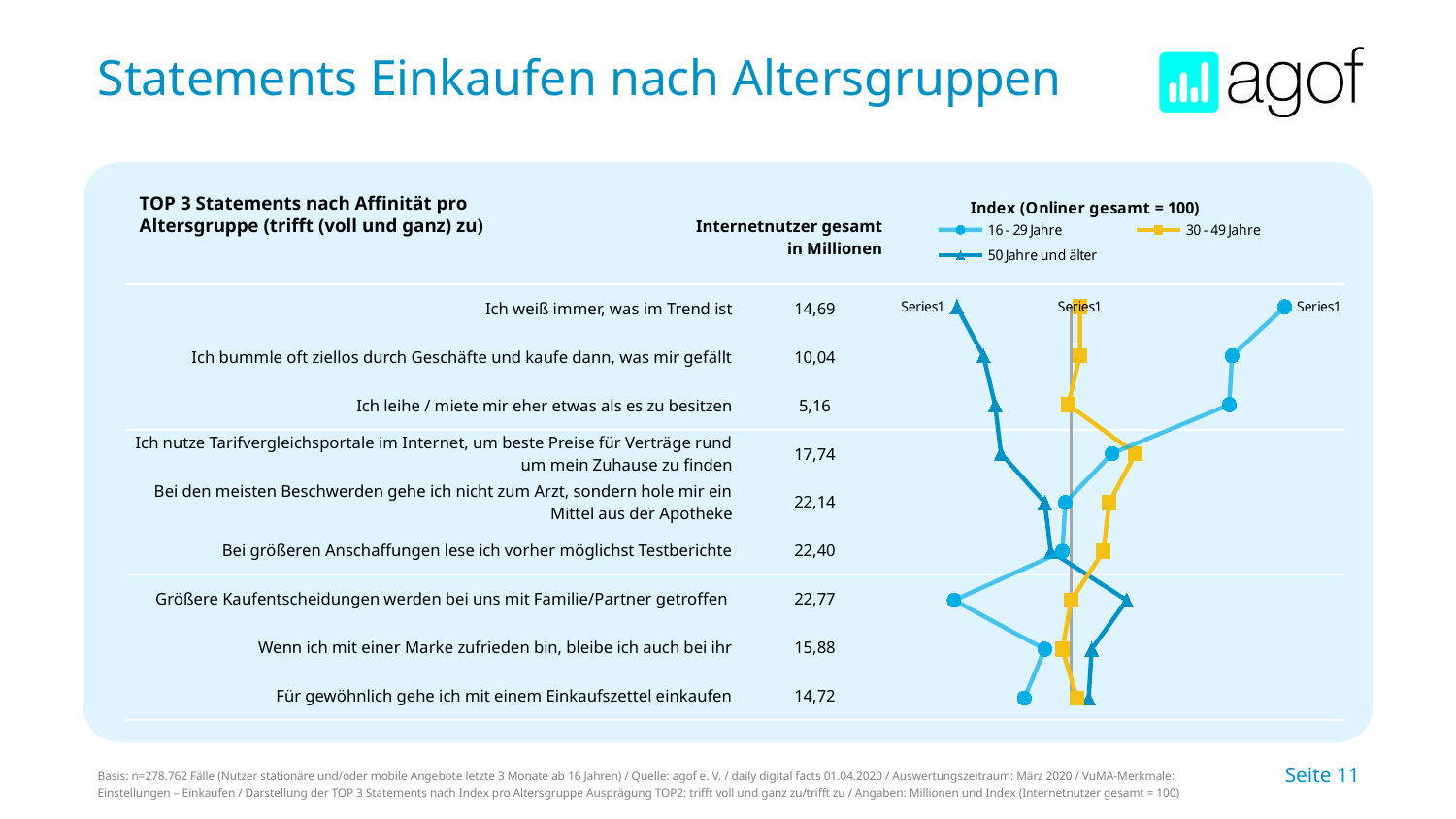
How many Internetnutzer gesamt in Millionen are shown for the statement 'Bei größeren Anschaffungen lese ich vorher möglichst Testberichte'? 22,40 What kind of chart is shown on the slide? line chart For the statement 'Ich weiß immer, was im Trend ist', is the index for 16 - 29 Jahre greater or less than 100? greater For the statement 'Größere Kaufentscheidungen werden bei uns mit Familie/Partner getroffen', which age group has the higher index, 16 - 29 Jahre or 50 Jahre und älter? 50 Jahre und älter For the statement 'Ich weiß immer, was im Trend ist', is the index for 50 Jahre und älter greater or less than 100? less For the statement 'Ich weiß immer, was im Trend ist', which age group has the higher index, 16 - 29 Jahre or 50 Jahre und älter? 16 - 29 Jahre How many statements are plotted in the chart? 9 What reference value does the index use for 'Onliner gesamt'? 100 For the statement 'Für gewöhnlich gehe ich mit einem Einkaufszettel einkaufen', is the index for 16 - 29 Jahre greater or less than 100? less How many Internetnutzer gesamt in Millionen are shown for the statement 'Ich leihe / miete mir eher etwas als es zu besitzen'? 5,16 How many series does the chart legend list? 3 Which age groups are listed in the chart legend? 16 - 29 Jahre, 30 - 49 Jahre, 50 Jahre und älter